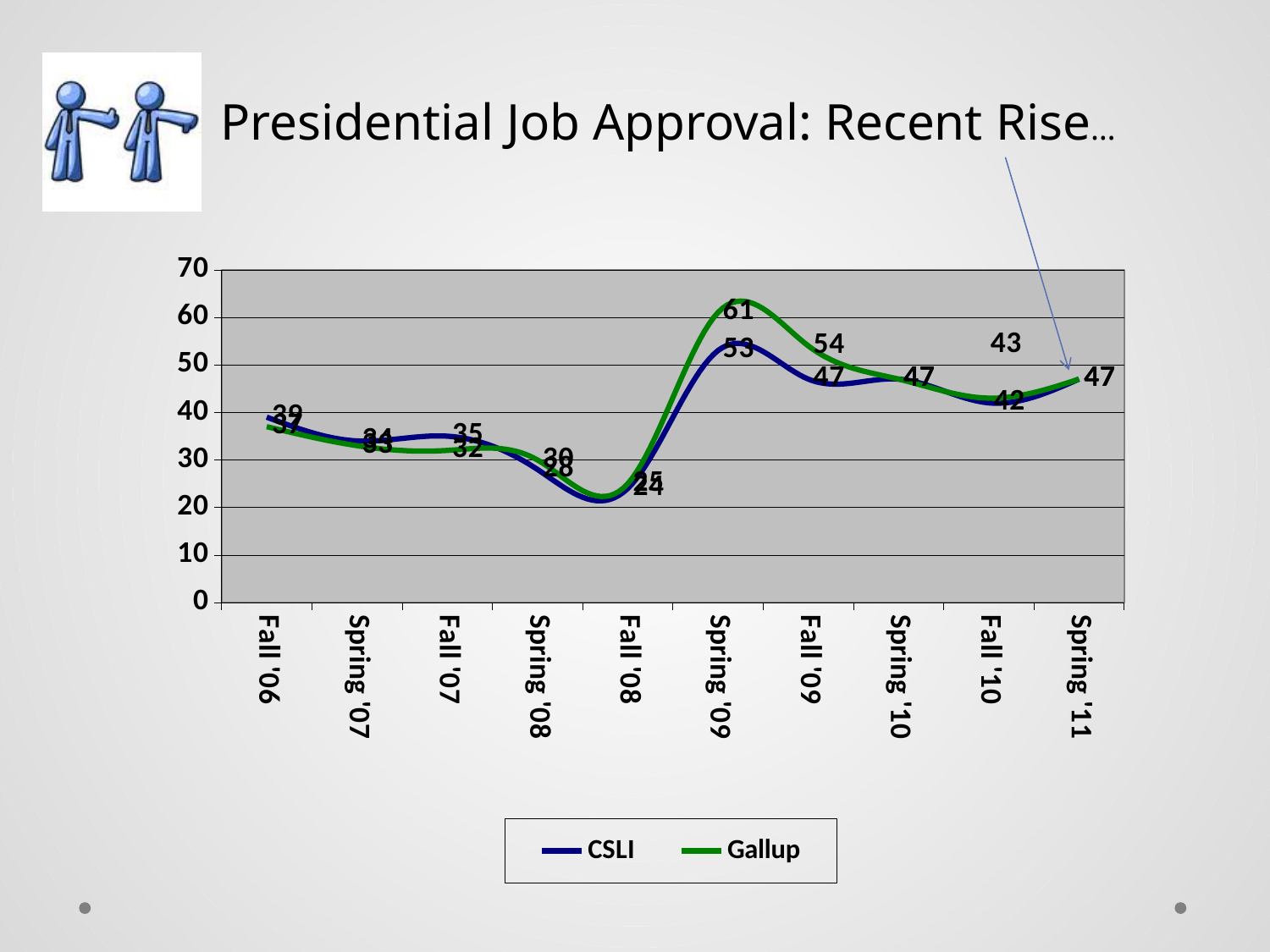
What is the Gallup value for Fall '10? 43 What kind of chart is shown on the slide? line chart What is the difference between the Gallup and CSLI values in Spring '09? 8 What is the CSLI value for Spring '09? 53 How many time points are shown on the x axis? 10 Is the CSLI value for Fall '08 greater or less than 30? less At which time point does the Gallup series reach its highest value? Spring '09 What is the Gallup value for Spring '09? 61 At which time point do both series reach their lowest value? Fall '08 What is the Gallup value for Fall '09? 54 How many series does the legend list? 2 Do the values rise or fall from Fall '06 to Fall '08? fall